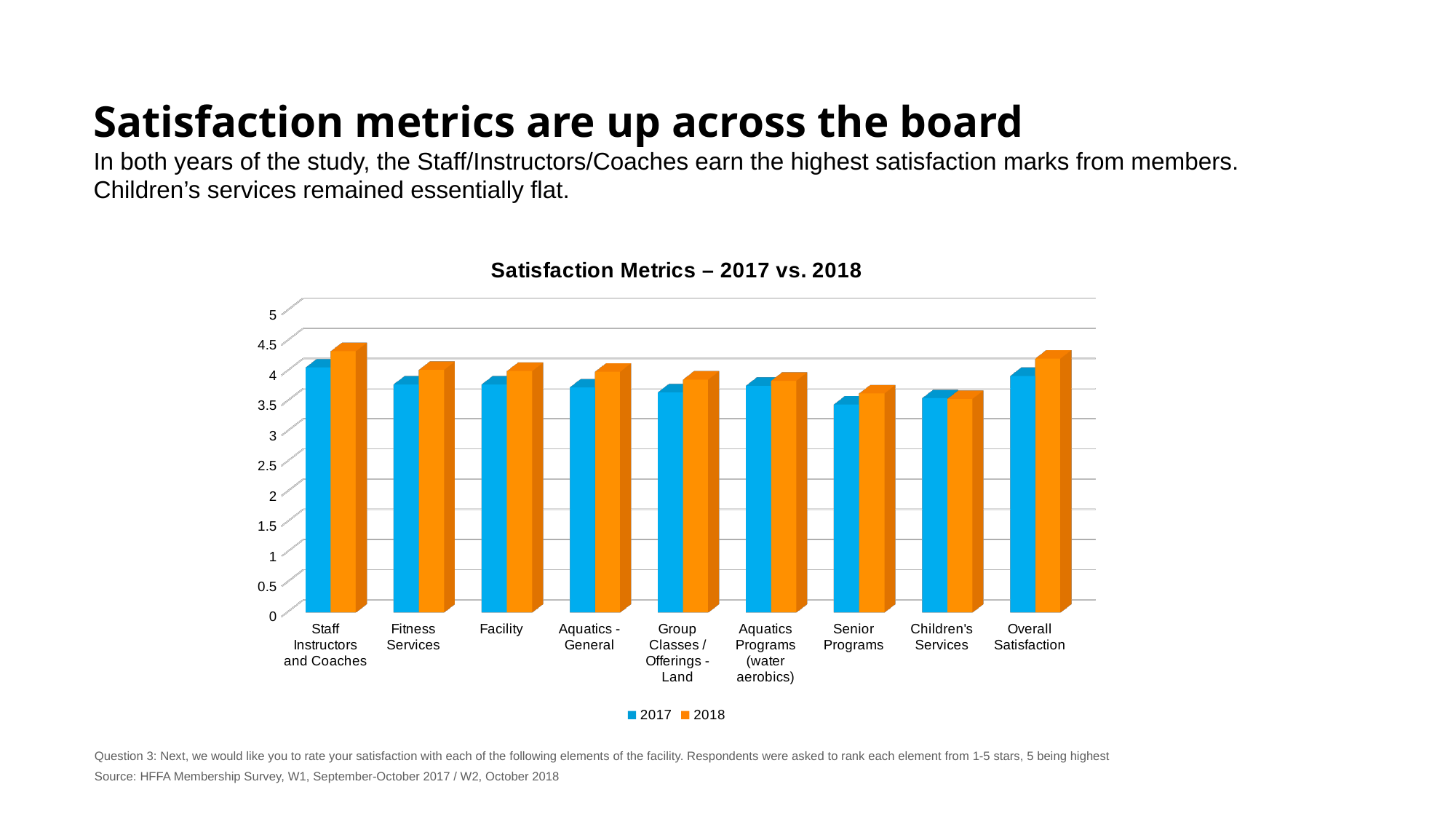
Which category has the highest 2017 value? Staff Instructors and Coaches Which category has the highest 2018 value? Staff Instructors and Coaches What is the title of the chart? Satisfaction Metrics – 2017 vs. 2018 How many series does the chart's legend list? 2 For Overall Satisfaction, which series has the larger value, 2017 or 2018? 2018 Is the 2017 value for Children's Services greater or less than 4? less Is the 2018 value for Staff Instructors and Coaches greater or less than 4? greater How many categories are shown on the x axis of the chart? 9 What kind of chart is shown on the slide? bar chart Is the 2018 value for Overall Satisfaction greater or less than 4? greater Which is larger: the 2018 value for Staff Instructors and Coaches or the 2018 value for Senior Programs? Staff Instructors and Coaches